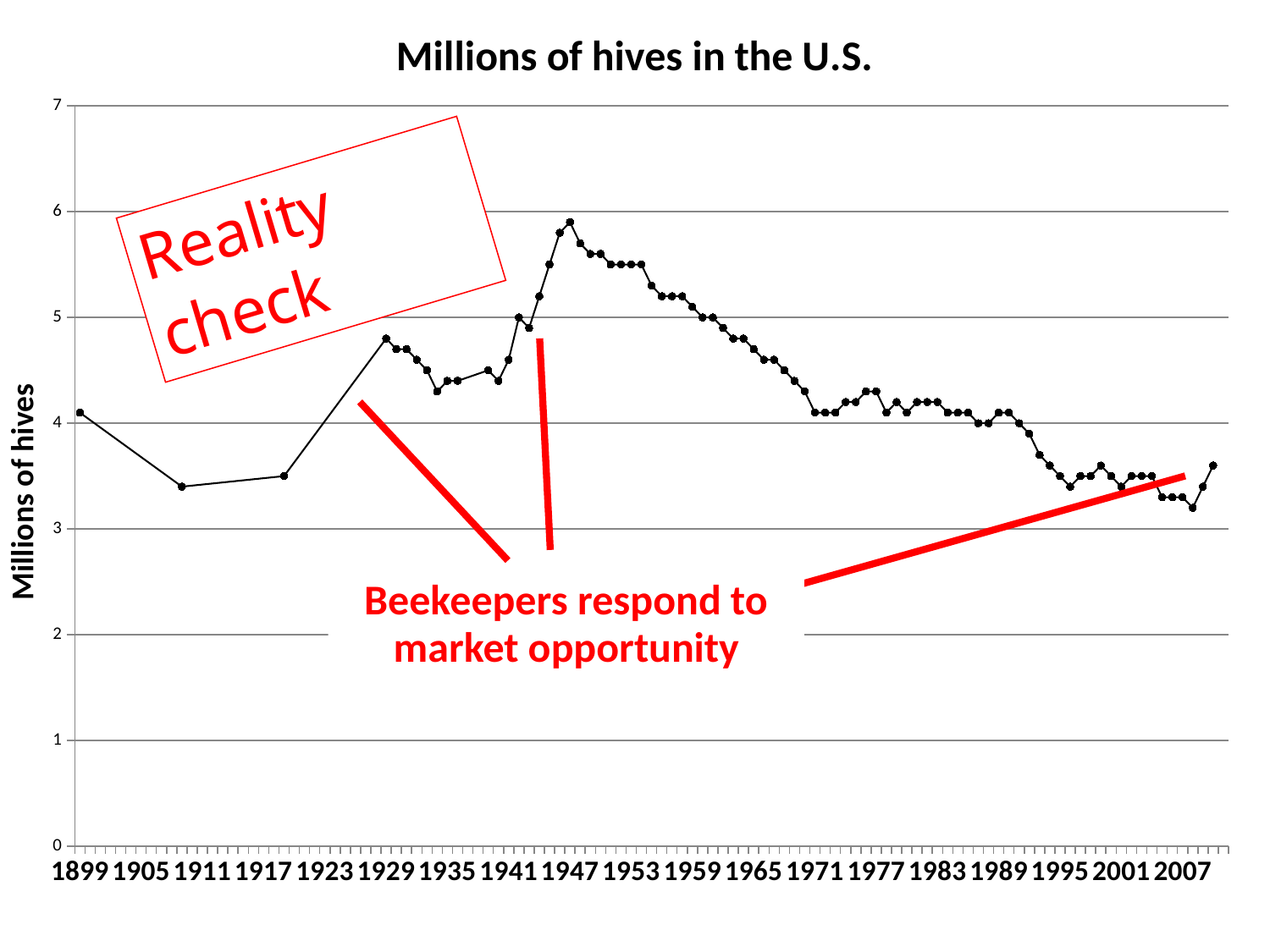
Is the value for 1947 greater or less than 5? greater Around which labeled year does the line reach its highest point? 1947 Is the value for 1899 greater or less than 4? greater What is the label on the vertical axis of the chart? Millions of hives Is the value for 1965 greater or less than 5? less Which year has the larger value, 1929 or 1947? 1947 Do the values generally rise or fall from 1947 to 2007? fall What is the title of the chart? Millions of hives in the U.S. What kind of chart is shown on the slide? line chart